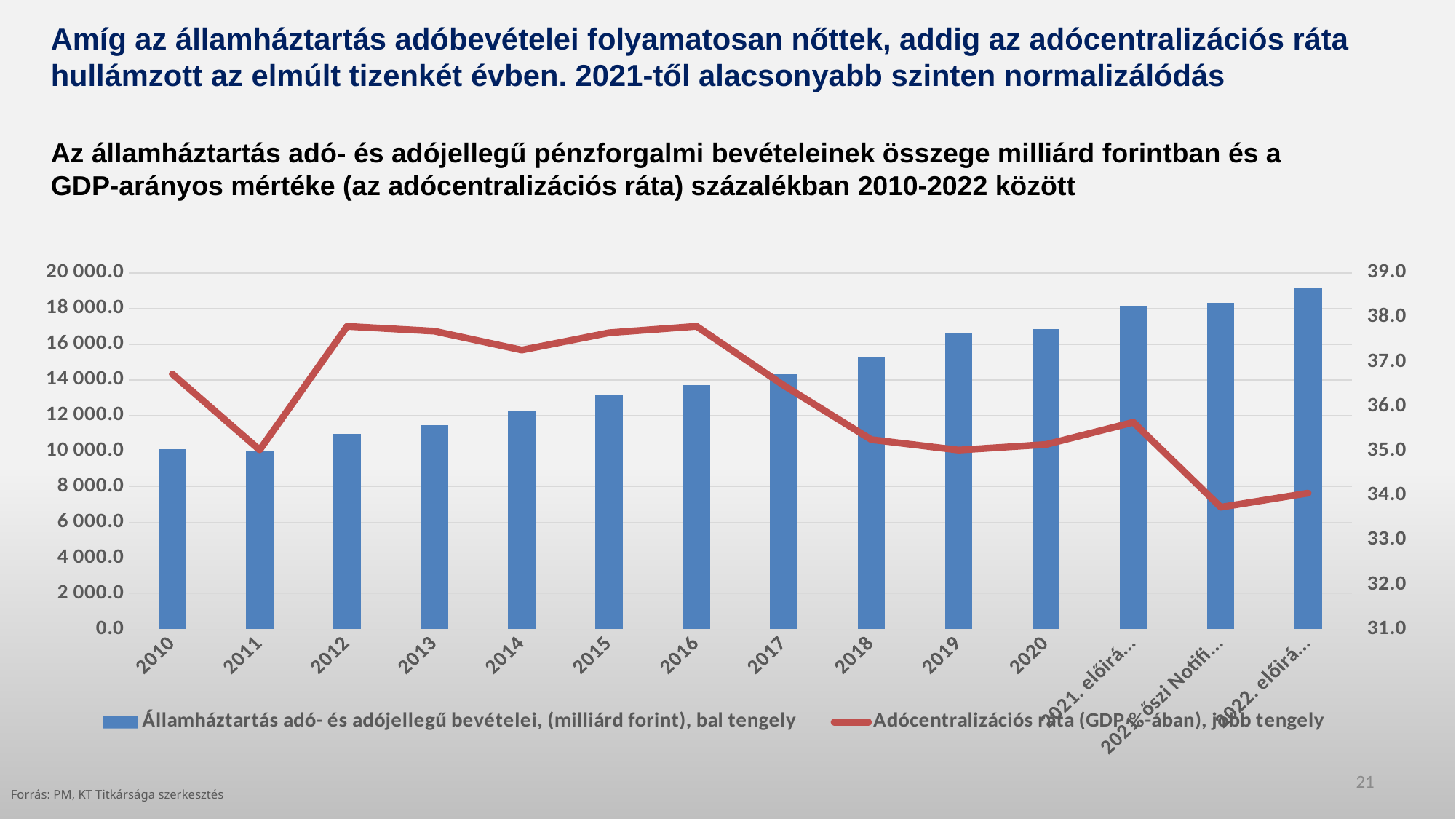
What colour is the Adócentralizációs ráta line? Red Which category has the tallest bar for Államháztartás adó- és adójellegű bevételei? 2022. előirá... How many categories are shown along the x axis? 14 Is the Adócentralizációs ráta value for 2011 greater or less than 36.0? less Which has the larger bar value, 2013 or 2016? 2016 Which category has the lowest value on the Adócentralizációs ráta line? 2021. őszi Notifi... Is the Adócentralizációs ráta value for 2012 greater or less than 37.0? greater Is the bar value for 2019 greater or less than 18 000.0? less What kind of chart is shown on the slide? A combination bar and line chart Do the bar values generally rise or fall from 2010 to 2022? rise How many series does the legend list? 2